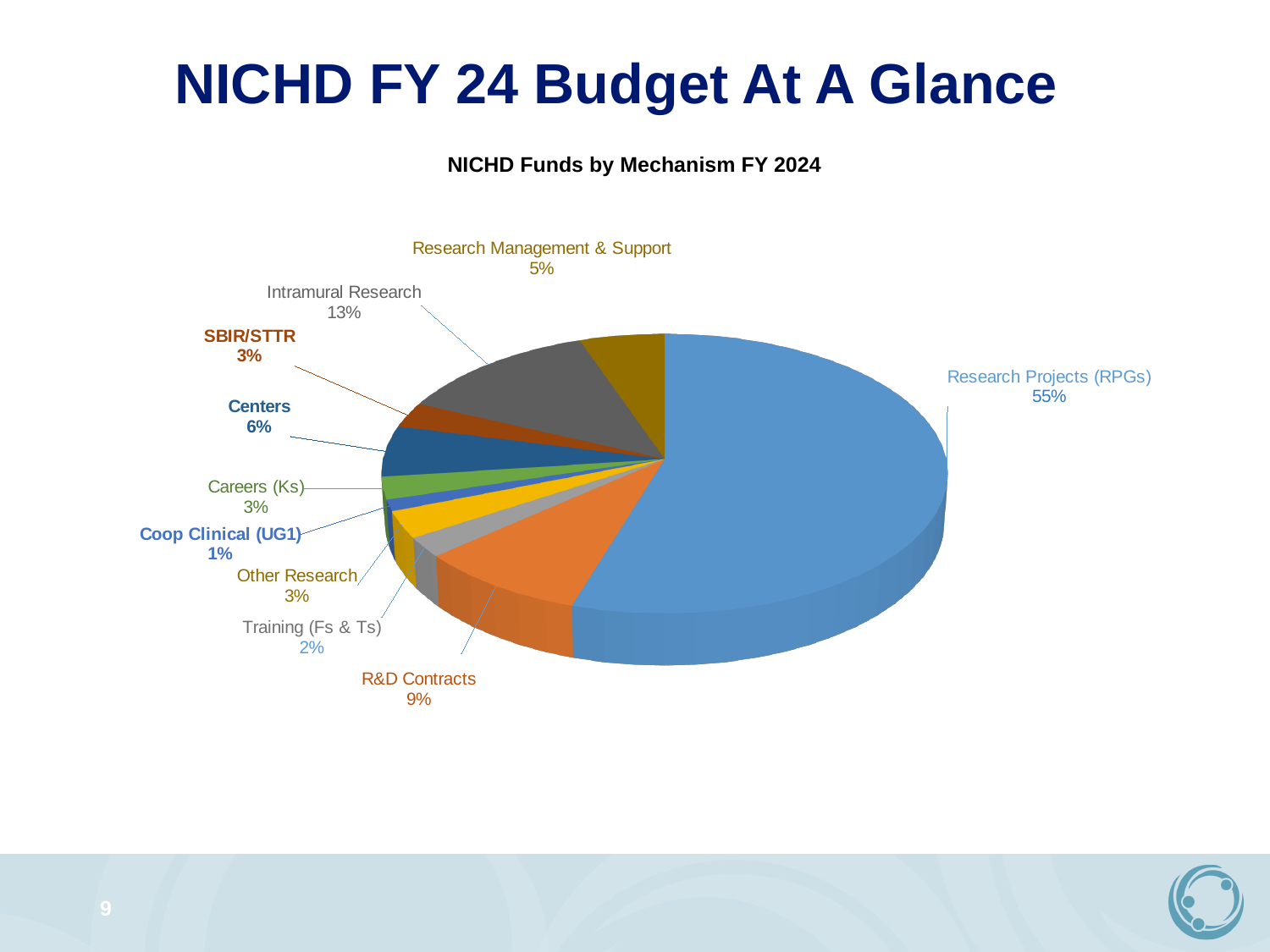
What is the title of the chart? NICHD Funds by Mechanism FY 2024 What percentage of funds goes to R&D Contracts? 9% What type of chart is shown on the slide? Pie chart Which mechanism receives the largest share of funds? Research Projects (RPGs) Which receives a larger share, Centers or Careers (Ks)? Centers What percentage of funds is allocated to Intramural Research? 13% What is the share for Research Management & Support? 5% What percentage of funds goes to Training (Fs & Ts)? 2% Which mechanism receives the smallest share of funds? Coop Clinical (UG1) How many mechanism categories are shown in the pie chart? 10 What is the difference in percentage points between Intramural Research and R&D Contracts? 4 What share of NICHD funds goes to Research Projects (RPGs)? 55%